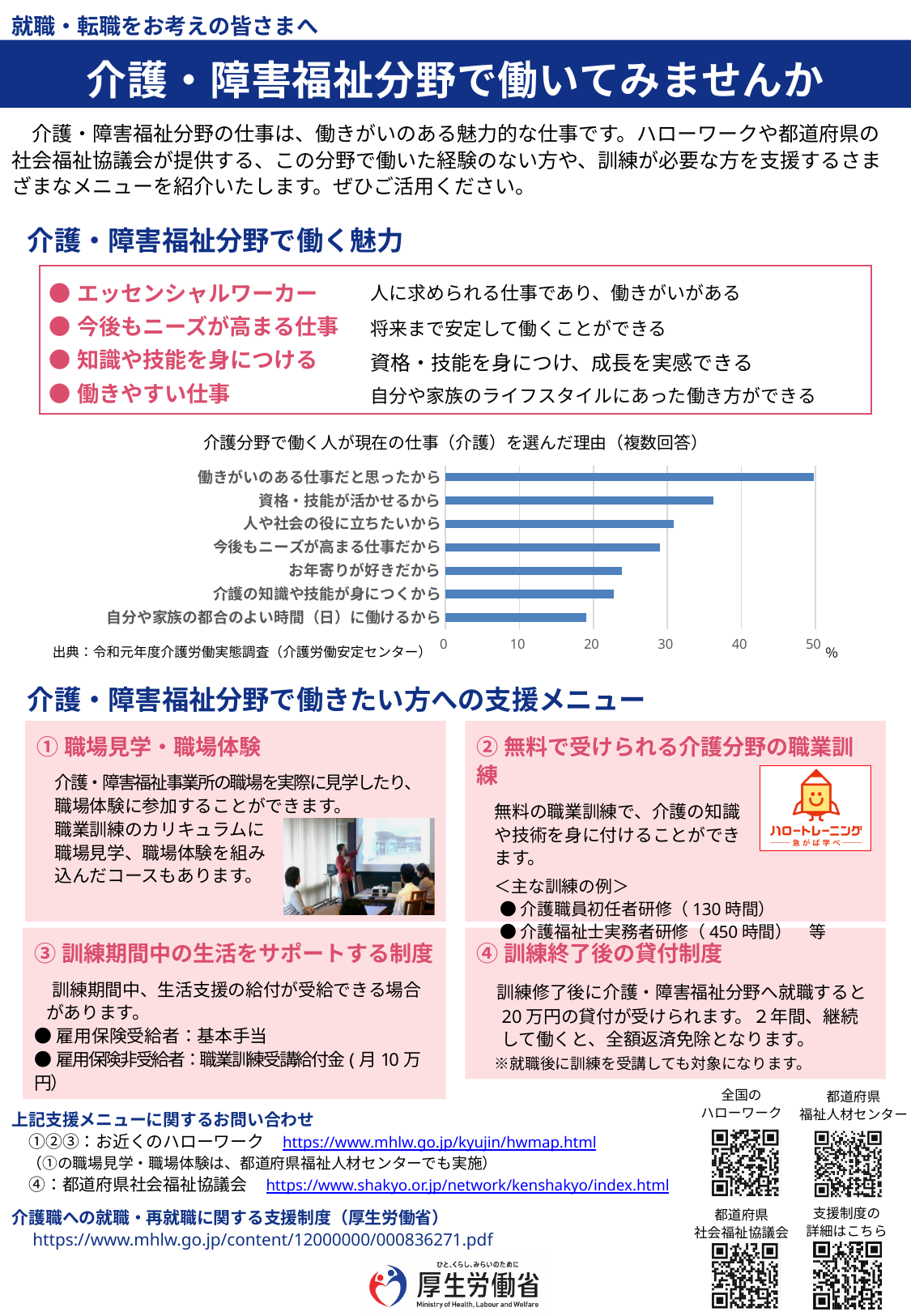
Is the value for 働きがいのある仕事だと思ったから greater or less than 40? greater Which reason has the lowest value in the chart? 自分や家族の都合のよい時間（日）に働けるから Which is larger: the value for 資格・技能が活かせるから or the value for 人や社会の役に立ちたいから? 資格・技能が活かせるから What is the title of the chart? 介護分野で働く人が現在の仕事（介護）を選んだ理由（複数回答） Is the value for 資格・技能が活かせるから greater or less than 30? greater What kind of chart is shown on the slide? bar chart Is the value for 介護の知識や技能が身につくから greater or less than 30? less How many reasons (categories) are plotted in the chart? 7 What unit is shown at the end of the chart's horizontal axis? % Which reason has the highest value in the chart? 働きがいのある仕事だと思ったから